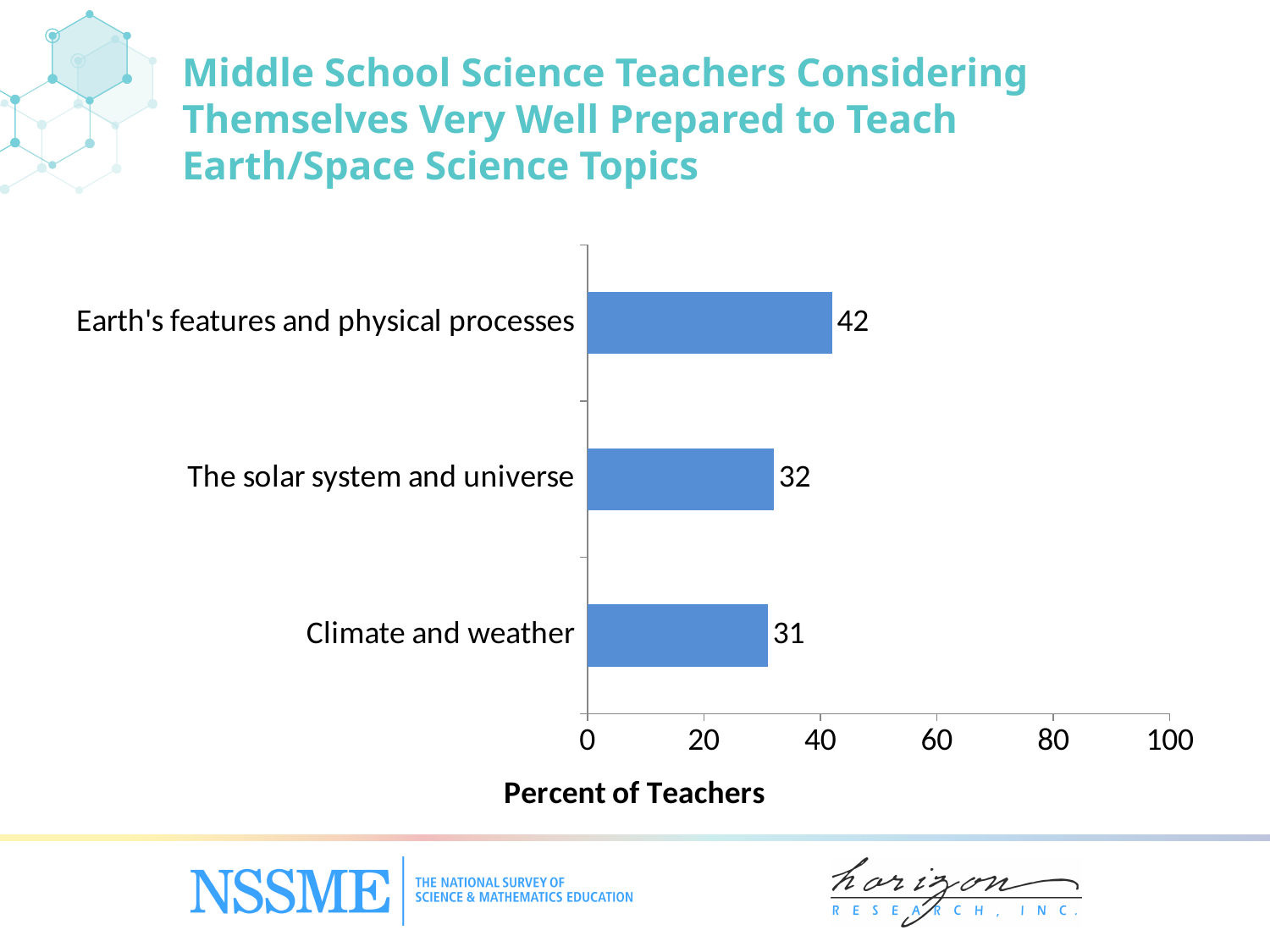
What is the difference between the values for The solar system and universe and Climate and weather? 1 What is the value for The solar system and universe? 32 What is the value for Climate and weather? 31 Which topic has the lowest percent of teachers? Climate and weather What is the difference between the values for Earth's features and physical processes and Climate and weather? 11 What kind of chart is shown on the slide? Bar chart How many topics are shown in the chart? 3 Which is larger, the value for Earth's features and physical processes or the value for The solar system and universe? Earth's features and physical processes Is the value for Earth's features and physical processes greater or less than 40? greater What is the label of the horizontal axis? Percent of Teachers What percent of teachers consider themselves very well prepared to teach Earth's features and physical processes? 42 Which topic has the highest percent of teachers? Earth's features and physical processes